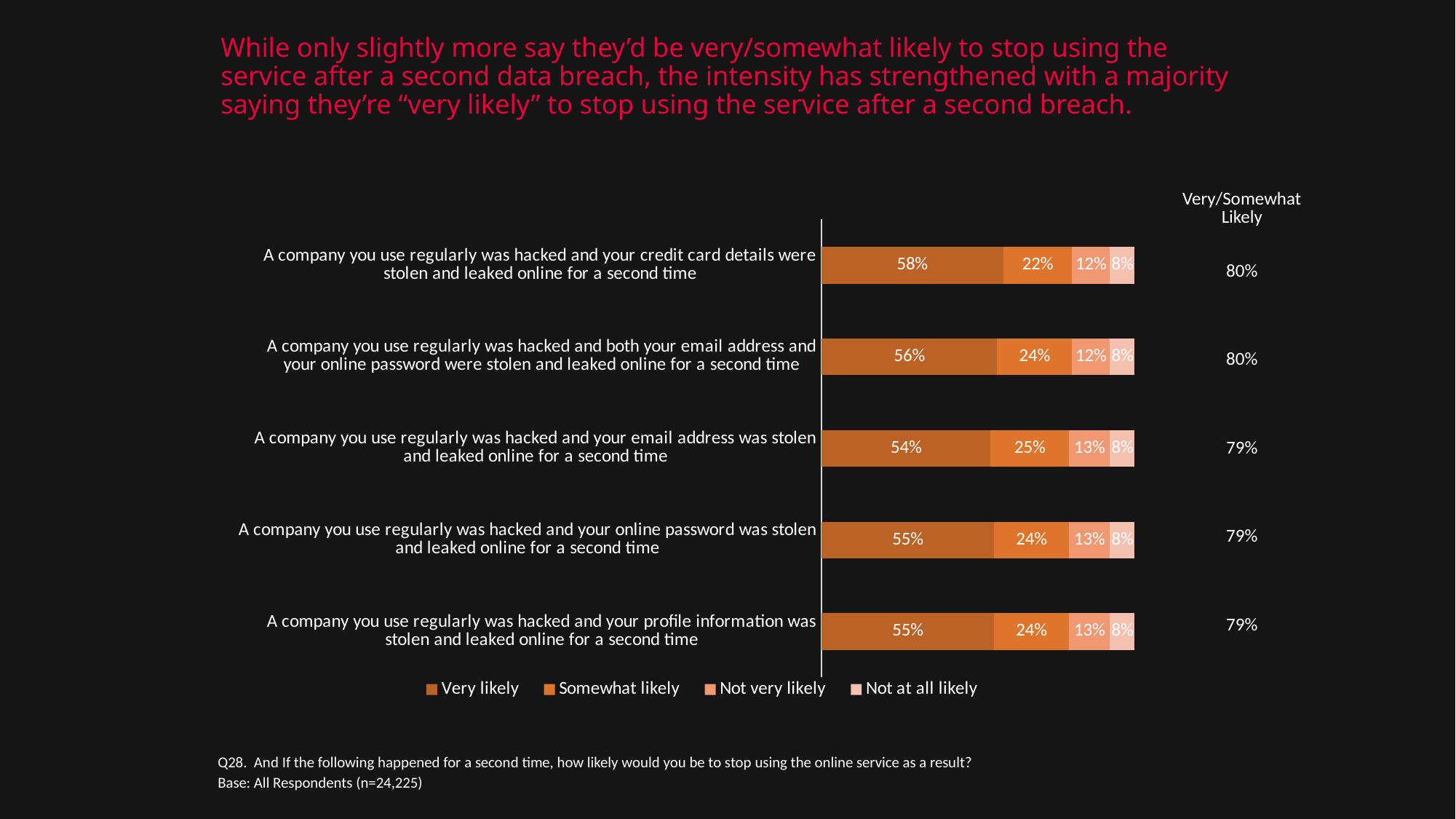
What is the "Somewhat likely" value for the scenario where the email address was stolen and leaked online for a second time? 25% Which scenario has the lowest "Very likely" percentage? A company you use regularly was hacked and your email address was stolen and leaked online for a second time How many scenarios (categories) are shown in the chart? 5 Is the "Very likely" value higher for the credit card details scenario or the online password scenario? Credit card details scenario What is the difference between the "Very likely" values for the credit card details scenario and the email address scenario? 4 percentage points What is the "Not very likely" value for the scenario where both email address and online password were stolen and leaked online for a second time? 12% Which scenario has the highest "Very likely" percentage? A company you use regularly was hacked and your credit card details were stolen and leaked online for a second time What percentage of respondents are "Very likely" to stop using the service if their credit card details were stolen and leaked online for a second time? 58% What kind of chart is shown on the slide? Stacked bar chart What is the "Not at all likely" value for the scenario where the online password was stolen and leaked online for a second time? 8% How many series does the legend list? 4 What is the Very/Somewhat Likely total shown for the scenario where profile information was stolen and leaked online for a second time? 79%